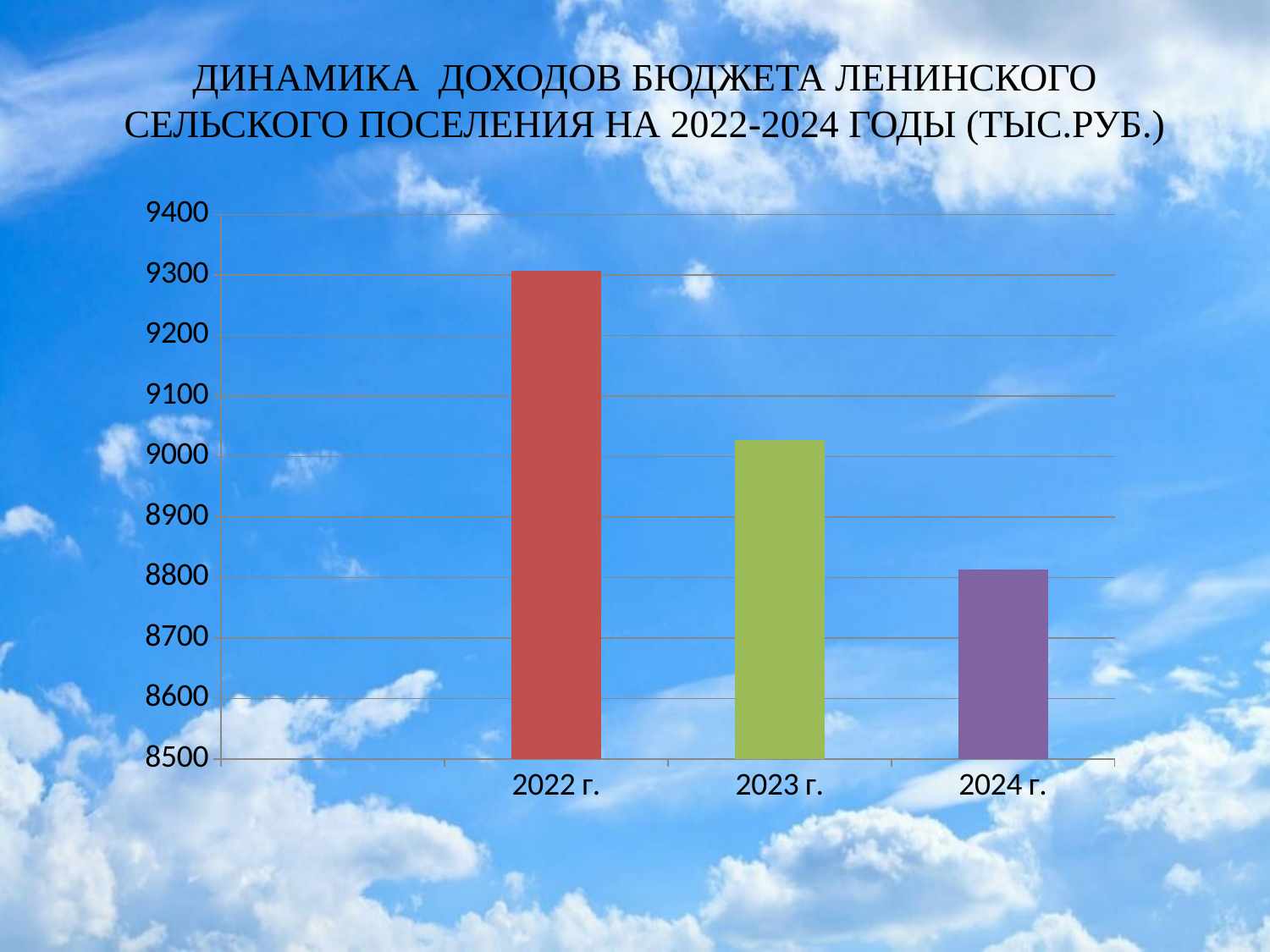
What colour is the bar for 2024 г.? purple How many bars (categories) does the chart show? 3 Which year has the lowest bar? 2024 г. Is the value for 2024 г. greater or less than 8900? less What is the lowest value shown on the vertical axis? 8500 Do the values rise or fall from 2022 г. to 2024 г.? fall Which is larger, the value for 2022 г. or the value for 2023 г.? 2022 г. What kind of chart is shown on the slide? bar chart Is the value for 2022 г. greater or less than 9200? greater Which is larger, the value for 2023 г. or the value for 2024 г.? 2023 г. Is the value for 2023 г. greater or less than 9100? less Which year has the highest bar? 2022 г.